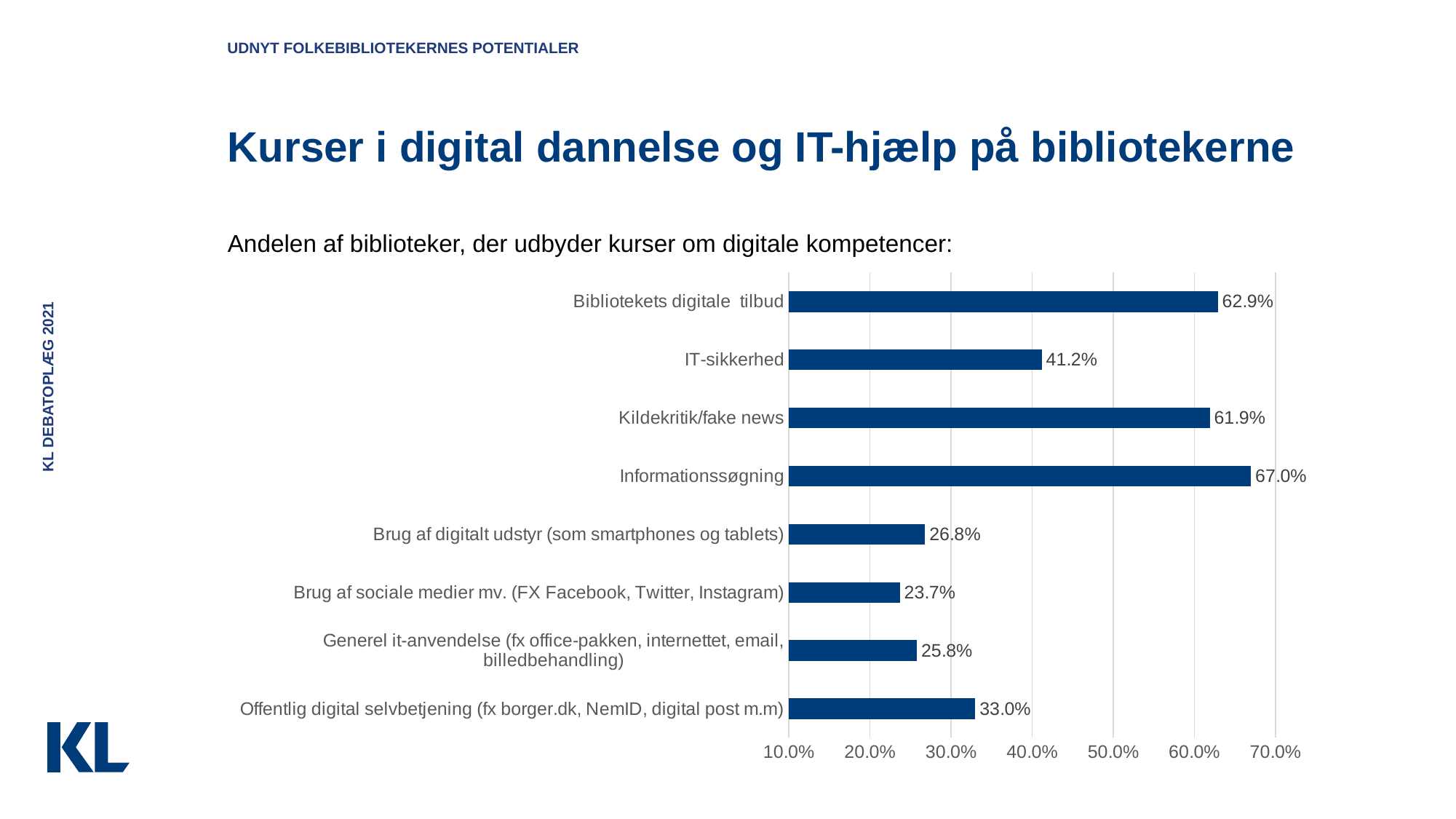
Which is larger: the value for Brug af digitalt udstyr (som smartphones og tablets) or the value for Offentlig digital selvbetjening (fx borger.dk, NemID, digital post m.m)? Offentlig digital selvbetjening (fx borger.dk, NemID, digital post m.m) What is the title of the slide containing the chart? Kurser i digital dannelse og IT-hjælp på bibliotekerne What is the difference between the values for Informationssøgning and IT-sikkerhed? 25.8% Which category has the lowest value? Brug af sociale medier mv. (FX Facebook, Twitter, Instagram) Which category has the highest value? Informationssøgning What kind of chart is shown on the slide? bar chart Is the value for IT-sikkerhed greater or less than 50.0%? less What is the value for Offentlig digital selvbetjening (fx borger.dk, NemID, digital post m.m)? 33.0% What is the value for Informationssøgning? 67.0% What is the value for IT-sikkerhed? 41.2% How many categories are shown in the chart? 8 What is the difference between the values for Bibliotekets digitale tilbud and Kildekritik/fake news? 1.0%